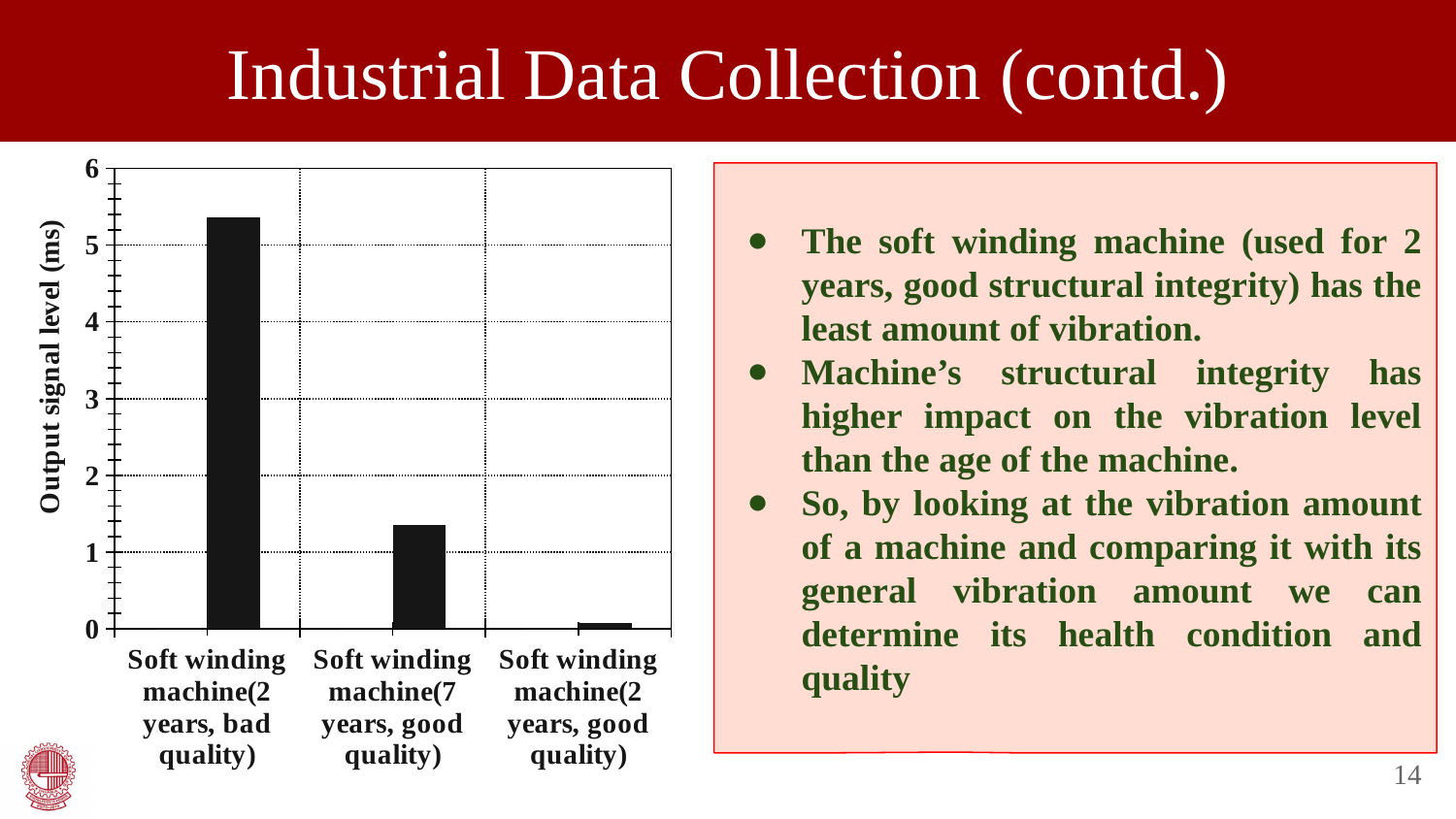
What kind of chart is shown on the slide? bar chart Which category has the lowest output signal level? Soft winding machine(2 years, good quality) Is the value for Soft winding machine(2 years, bad quality) greater or less than 5? greater How many categories (bars) are plotted in the chart? 3 Is the value for Soft winding machine(7 years, good quality) greater or less than 1? greater Is the value for Soft winding machine(7 years, good quality) greater or less than 2? less What is the maximum value shown on the vertical axis of the chart? 6 Which category has the highest output signal level? Soft winding machine(2 years, bad quality) Which has a larger output signal level: Soft winding machine(7 years, good quality) or Soft winding machine(2 years, good quality)? Soft winding machine(7 years, good quality) What is the label of the vertical axis of the chart? Output signal level (ms) Do the bar values rise or fall from left to right along the x axis? fall